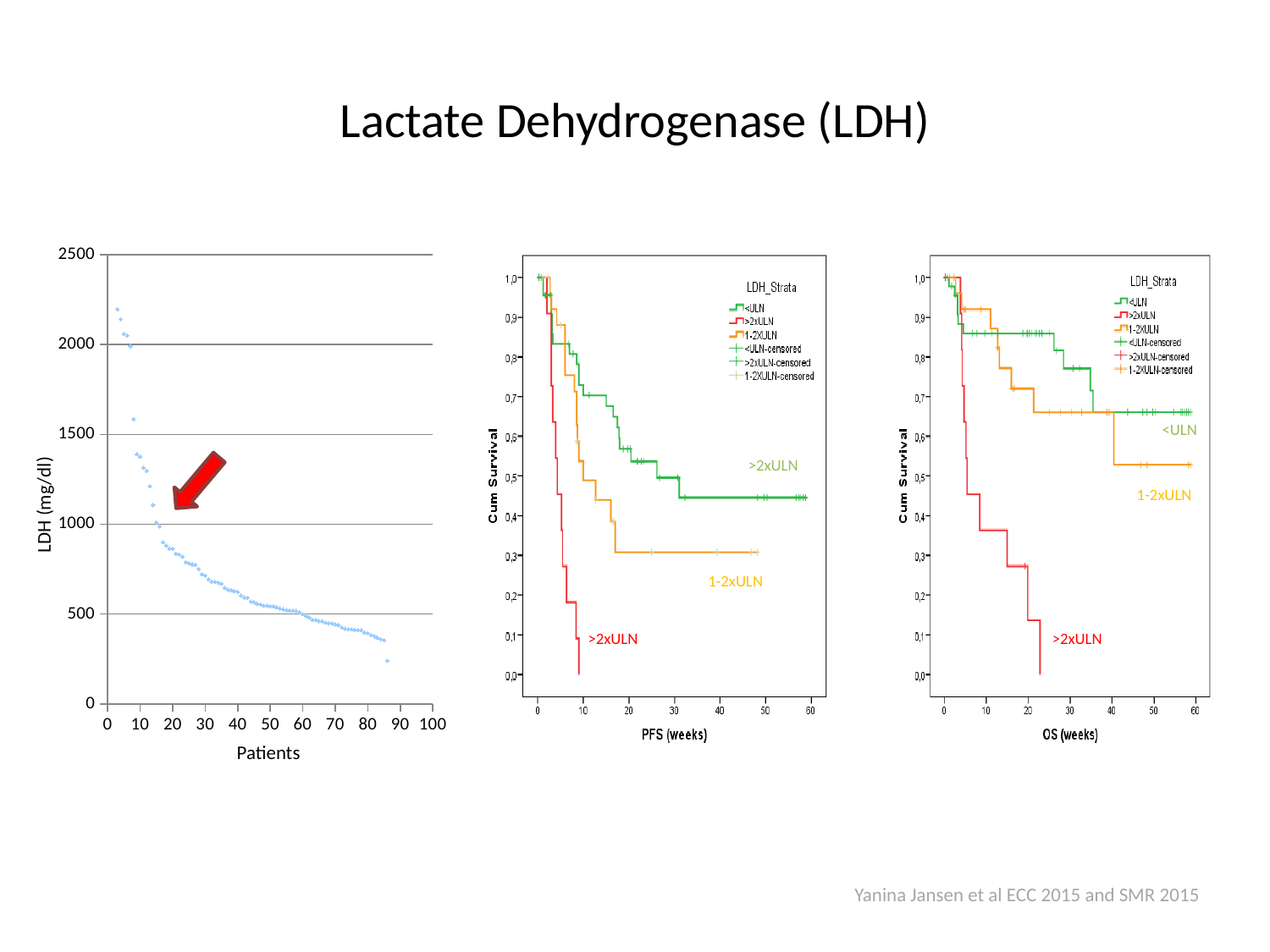
In the middle chart (PFS), is the cumulative survival of the 1-2xULN curve at 40 weeks greater or less than 0.4? less In the middle chart (PFS), how many entries does the LDH_Strata legend list? 6 In the middle chart (PFS), is the cumulative survival of the green curve at 40 weeks greater or less than 0.4? greater In the left chart, is the highest LDH value plotted greater or less than 2000? greater In the middle chart (PFS), which LDH stratum has the lowest cumulative survival? >2xULN In the left chart, what is the label of the y axis? LDH (mg/dl) In the left chart, do the LDH values rise or fall as the patient number increases along the x axis? fall In the right chart (OS), which curve is higher at 50 weeks, the <ULN curve or the 1-2xULN curve? <ULN In the middle chart, what is the label of the x axis? PFS (weeks) What kind of chart is the left chart showing LDH (mg/dl) against Patients? scatter chart